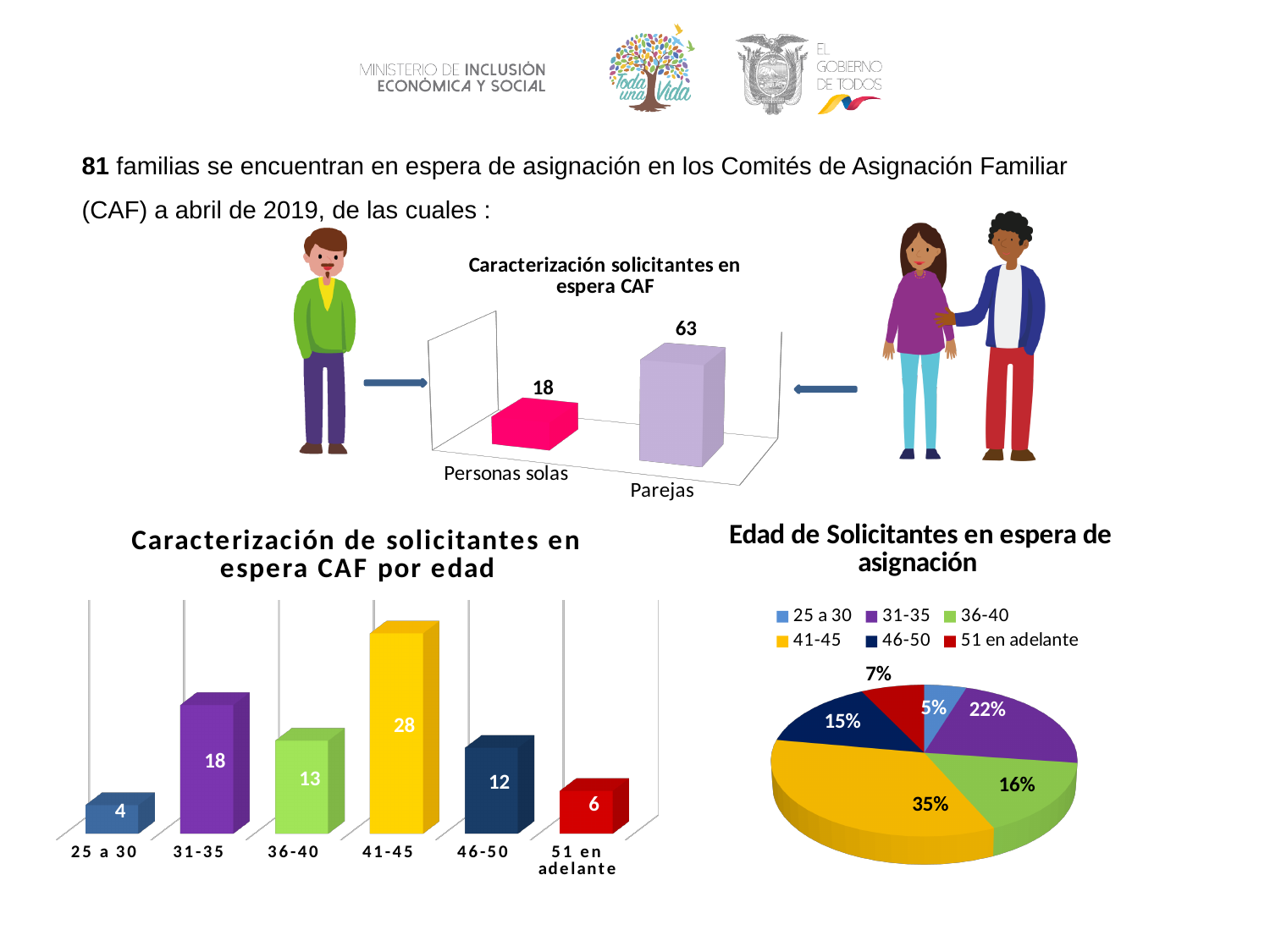
In the pie chart titled "Edad de Solicitantes en espera de asignación", what share does 51 en adelante have? 7% In the chart titled "Caracterización solicitantes en espera CAF", what is the difference between Parejas and Personas solas? 45 How many entries does the legend of the pie chart "Edad de Solicitantes en espera de asignación" list? 6 In the pie chart titled "Edad de Solicitantes en espera de asignación", what share does 41-45 have? 35% In the chart titled "Caracterización de solicitantes en espera CAF por edad", which age group has the highest value? 41-45 In the chart titled "Caracterización solicitantes en espera CAF", what is the value for Parejas? 63 In the chart titled "Caracterización solicitantes en espera CAF", how many categories are shown? 2 In the chart titled "Caracterización de solicitantes en espera CAF por edad", what is the value for 41-45? 28 What kind of chart is "Caracterización de solicitantes en espera CAF por edad"? bar chart In the chart titled "Caracterización de solicitantes en espera CAF por edad", what is the difference between 31-35 and 36-40? 5 In the chart titled "Caracterización de solicitantes en espera CAF por edad", which age group has the lowest value? 25 a 30 In the chart titled "Caracterización de solicitantes en espera CAF por edad", which is larger, 46-50 or 51 en adelante? 46-50